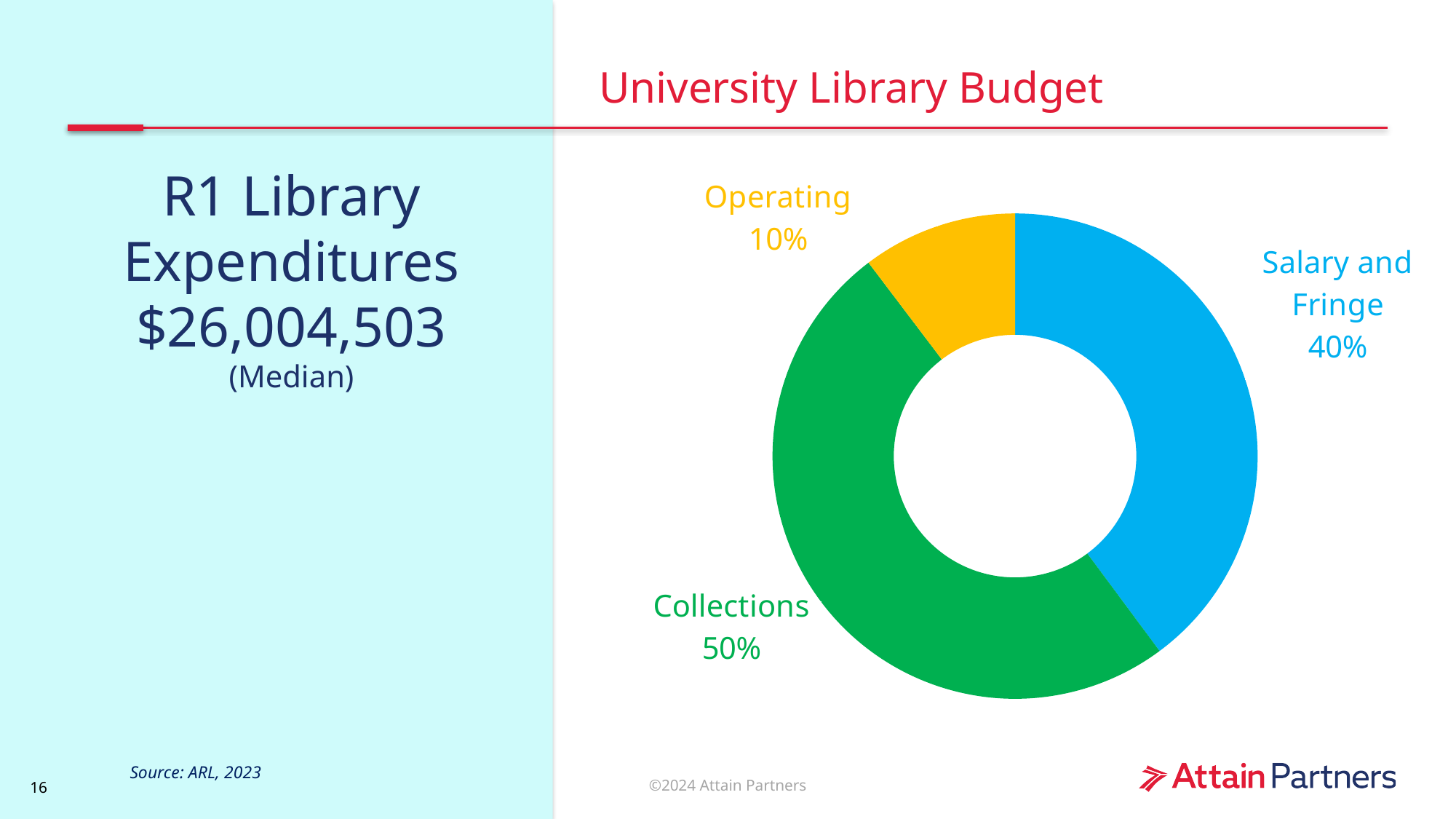
What share of the University Library Budget goes to Salary and Fringe? 40% What colour is the Collections slice in the chart? Green What share of the University Library Budget goes to Operating? 10% How many percentage points larger is the Salary and Fringe share than the Operating share? 30% Which category has the largest share of the University Library Budget? Collections Which is larger, the share for Salary and Fringe or the share for Operating? Salary and Fringe What kind of chart is used to show the University Library Budget? Pie chart (donut) How many percentage points larger is the Collections share than the Salary and Fringe share? 10% How many categories are shown in the University Library Budget chart? 3 What is the median R1 Library Expenditures figure shown on the slide? $26,004,503 What share of the University Library Budget goes to Collections? 50% Which category has the smallest share of the University Library Budget? Operating